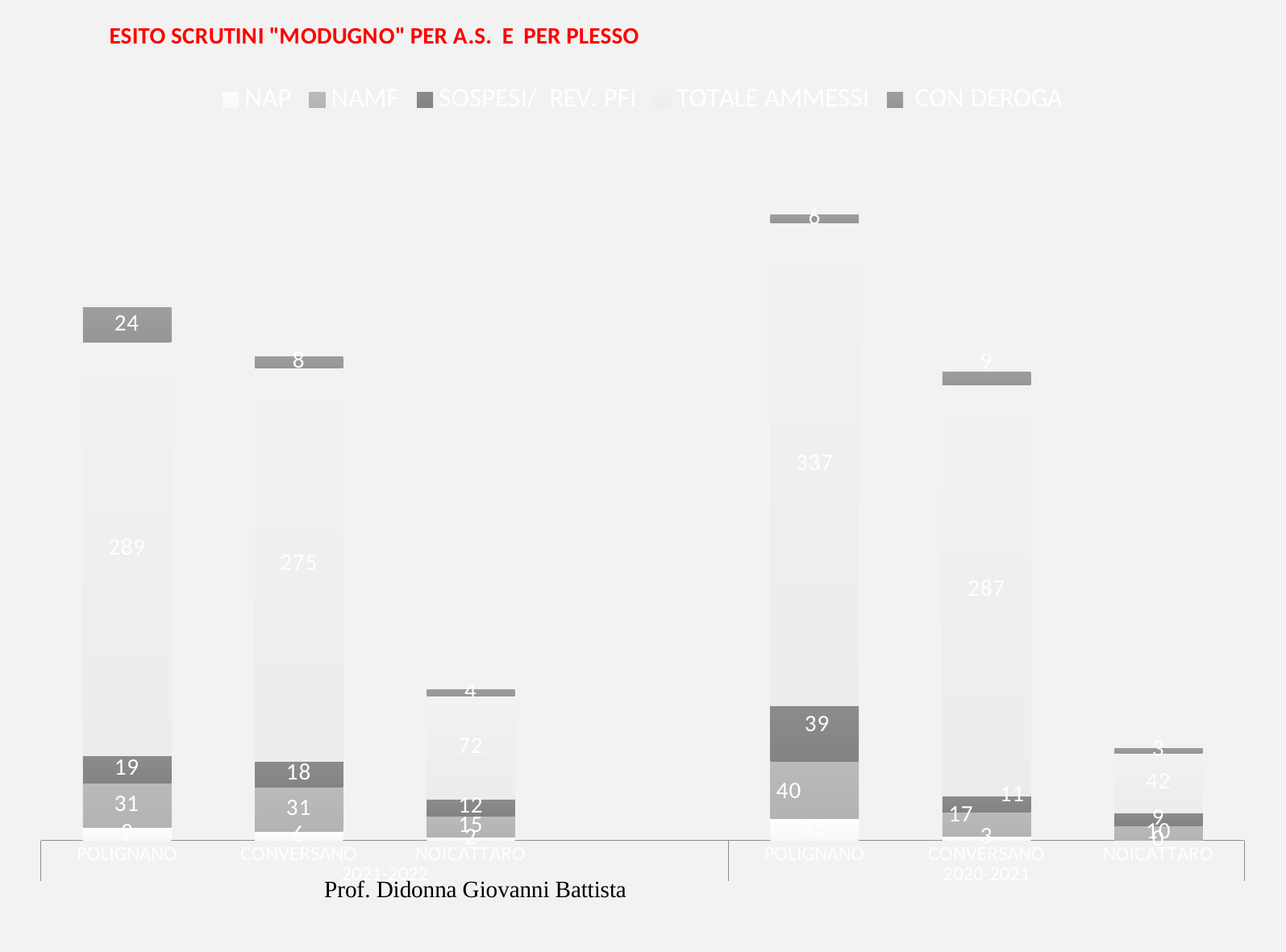
What is the difference between the TOTALE AMMESSI values for POLIGNANO and CONVERSANO in 2020-2021? 50 What is the CON DEROGA value for POLIGNANO in 2021-2022? 24 What is the TOTALE AMMESSI value for NOICATTARO in 2021-2022? 72 What is the TOTALE AMMESSI value for POLIGNANO in 2021-2022? 289 What kind of chart is shown on the slide? stacked bar chart How many series does the legend list? 5 Is the NAMF value for POLIGNANO larger in 2020-2021 or in 2021-2022? 2020-2021 Which plesso has the highest TOTALE AMMESSI value in 2020-2021? POLIGNANO What is the title of the chart? ESITO SCRUTINI "MODUGNO" PER A.S. E PER PLESSO What is the SOSPESI/ REV. PFI value for POLIGNANO in 2020-2021? 39 Which plesso has the lowest TOTALE AMMESSI value in 2021-2022? NOICATTARO What is the TOTALE AMMESSI value for POLIGNANO in 2020-2021? 337